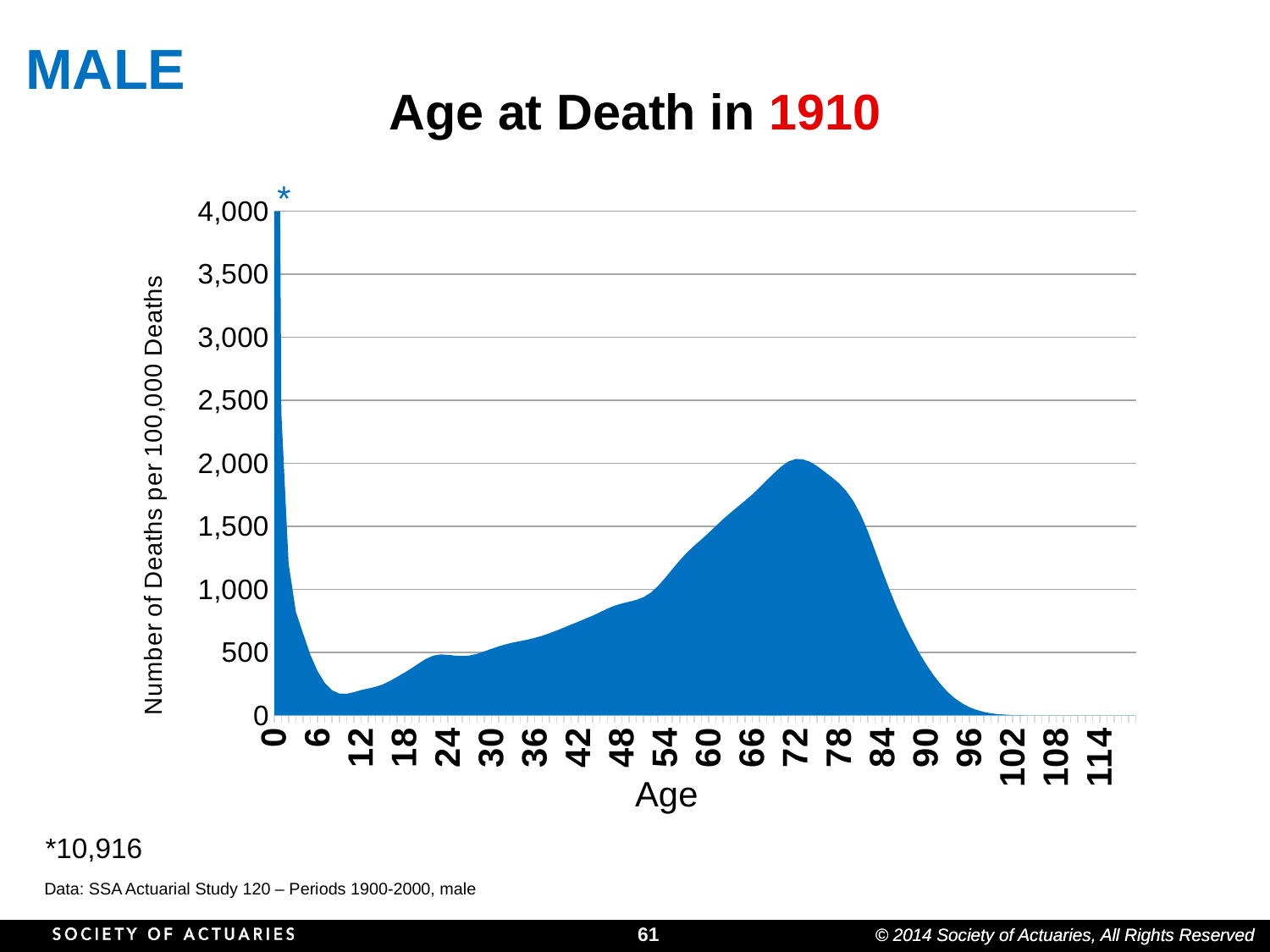
Do the values rise or fall as age increases from 54 to 72? rise Is the value at age 60 greater or less than 1,000? greater What is the label of the y axis? Number of Deaths per 100,000 Deaths Do the values rise or fall as age increases from 78 to 96? fall What is the title of the chart? Age at Death in 1910 Which age has the highest number of deaths per 100,000 deaths? 0 Is the value at age 12 greater or less than 500? less Is the value at age 96 greater or less than 500? less What kind of chart is shown on the slide? Area chart According to the footnote, what is the number of deaths per 100,000 deaths at age 0? 10,916 Which age has the larger value, 24 or 72? 72